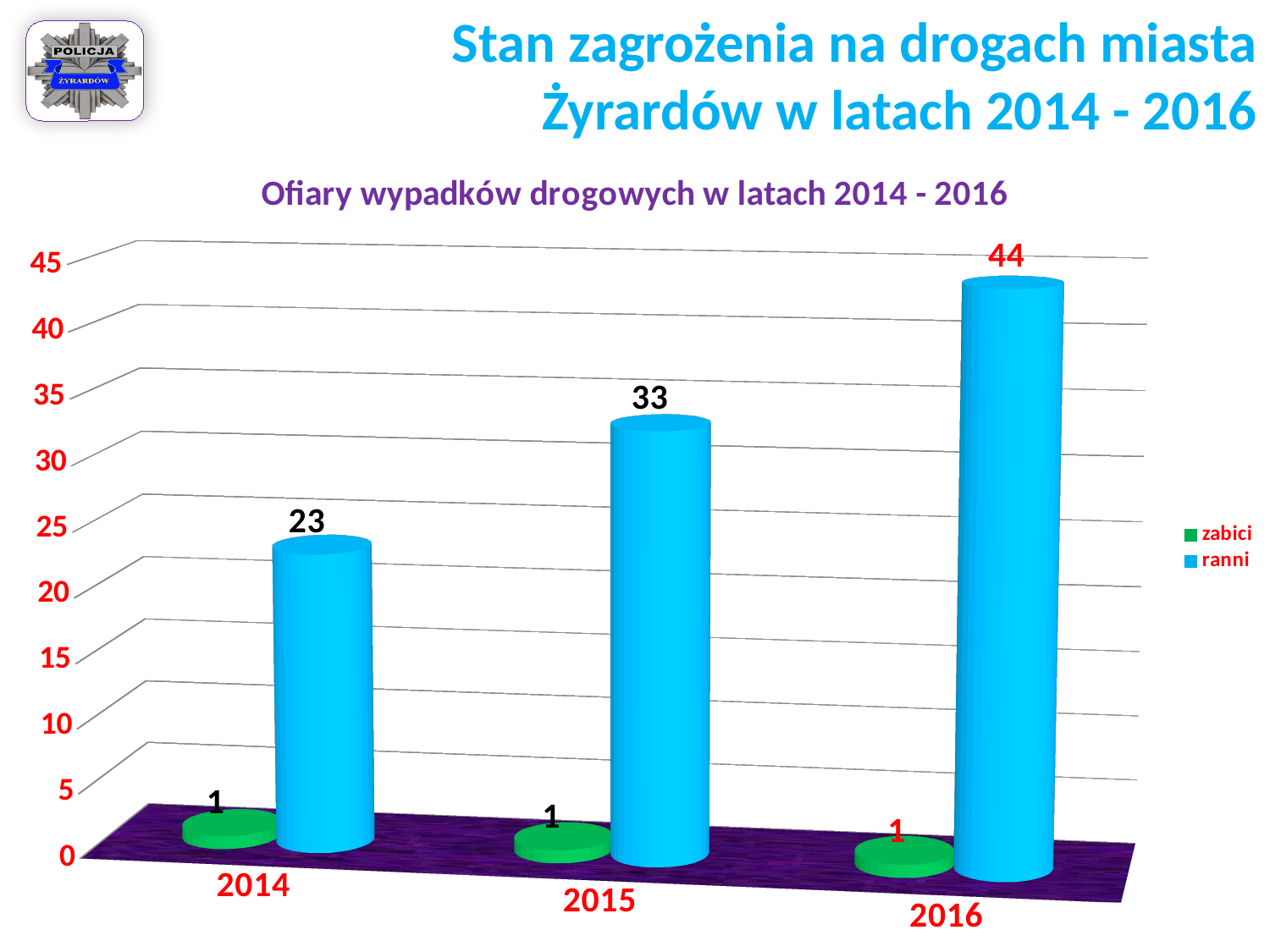
How many years are shown on the x axis? 3 What is the value for 'ranni' in 2016? 44 What is the value for 'zabici' in 2015? 1 What kind of chart is shown? bar chart Is the value for 'ranni' in 2015 greater or less than 30? greater Which year has the highest value for 'ranni'? 2016 Do the 'ranni' values rise or fall from 2014 to 2016? rise What is the difference between the 'ranni' values for 2016 and 2015? 11 Which year has the lowest value for 'ranni'? 2014 What is the value for 'ranni' in 2014? 23 Which is larger: 'ranni' in 2015 or 'ranni' in 2014? 2015 How many series does the legend list? 2